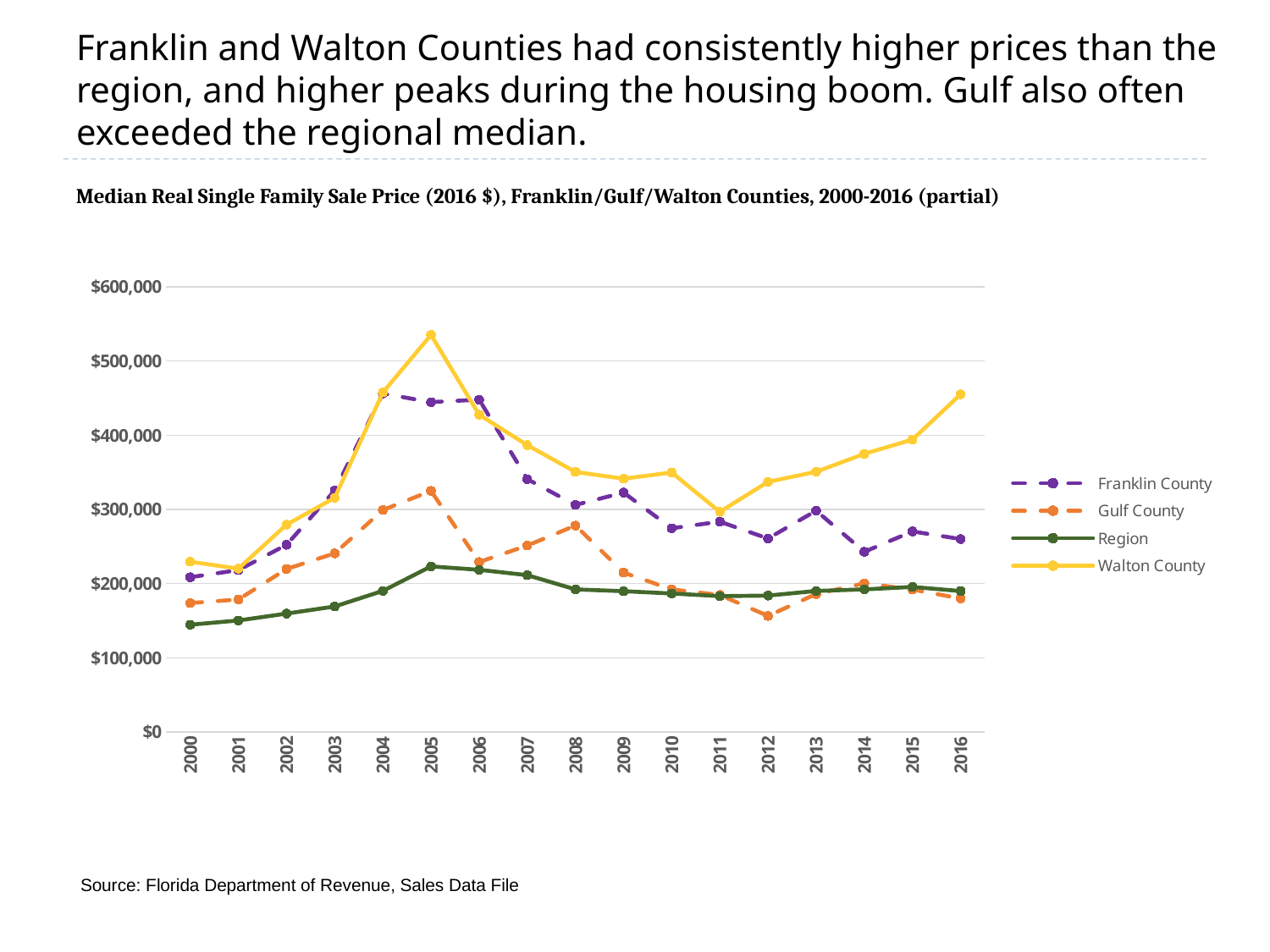
Is the value for Gulf County in 2012 greater or less than $200,000? less Which series is drawn as a solid green line? Region Which series has the highest value in 2005? Walton County Is the value for Franklin County in 2004 greater or less than $400,000? greater In which year does Walton County reach its highest median sale price? 2005 Do Walton County's values rise or fall from 2011 to 2016? rise How many series does the legend list? 4 How many years are plotted along the x axis? 17 What kind of chart is shown on the slide? line chart Is the value for Walton County in 2005 greater or less than $500,000? greater Which is larger in 2016, the value for Walton County or the value for Franklin County? Walton County Which series has the lowest value in 2000? Region